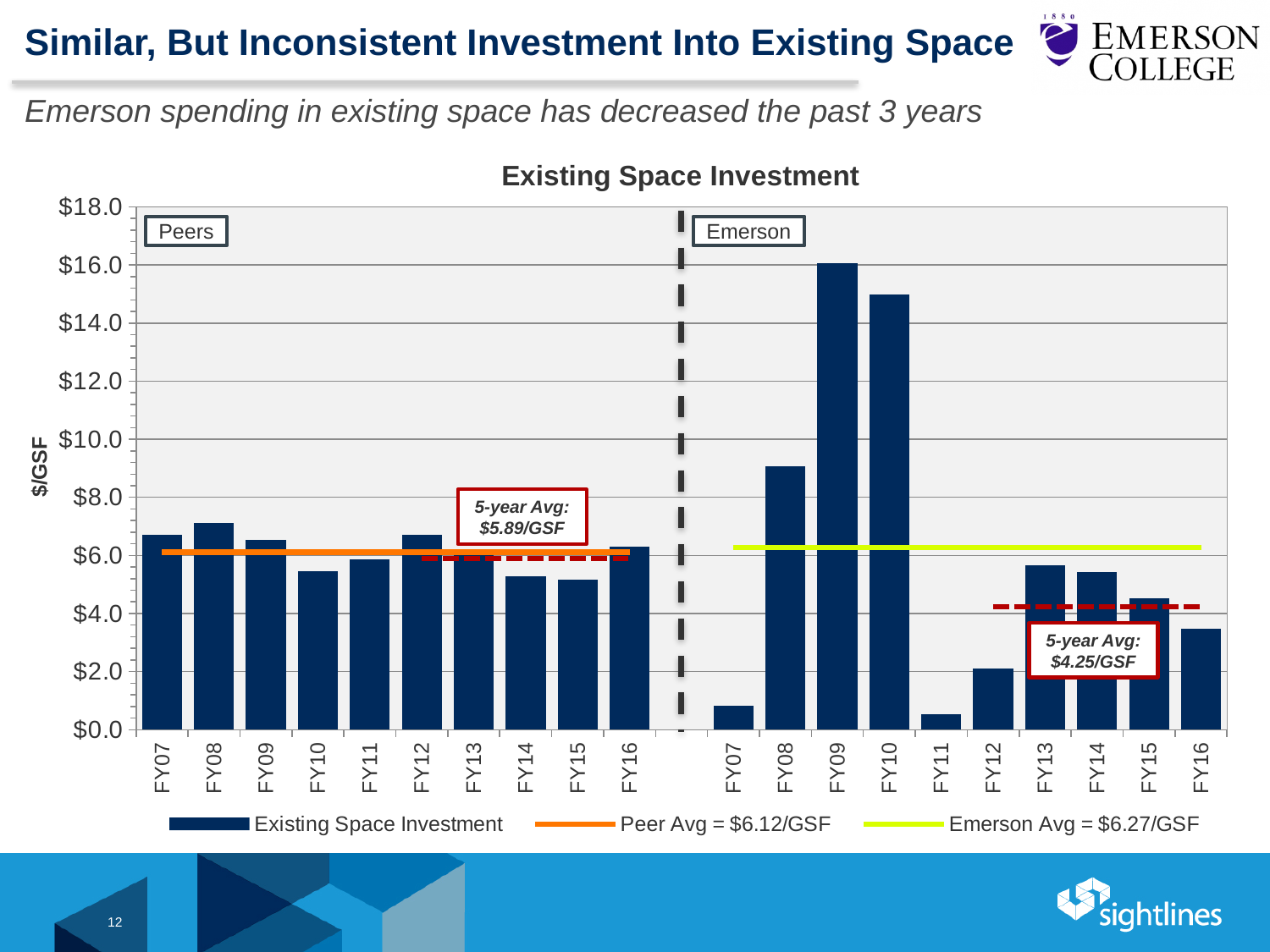
What is the Peer Avg value shown in the chart legend? $6.12/GSF Do the Emerson bars rise or fall from FY13 to FY16? Fall What is the Emerson Avg value shown in the chart legend? $6.27/GSF What is the difference between the Peers 5-year average and the Emerson 5-year average shown in the callout boxes? $1.64/GSF Which fiscal year has the lowest bar in the Emerson group? FY11 What kind of chart is shown on the slide? Bar chart How many entries does the chart legend list? 3 What is the 5-year average for Emerson shown in the callout box? $4.25/GSF Which fiscal year has the highest bar in the Emerson group? FY09 How many bars are plotted in the Emerson group of the chart? 10 What is the title of the chart? Existing Space Investment Is the Emerson FY10 value greater or less than $14.0? greater